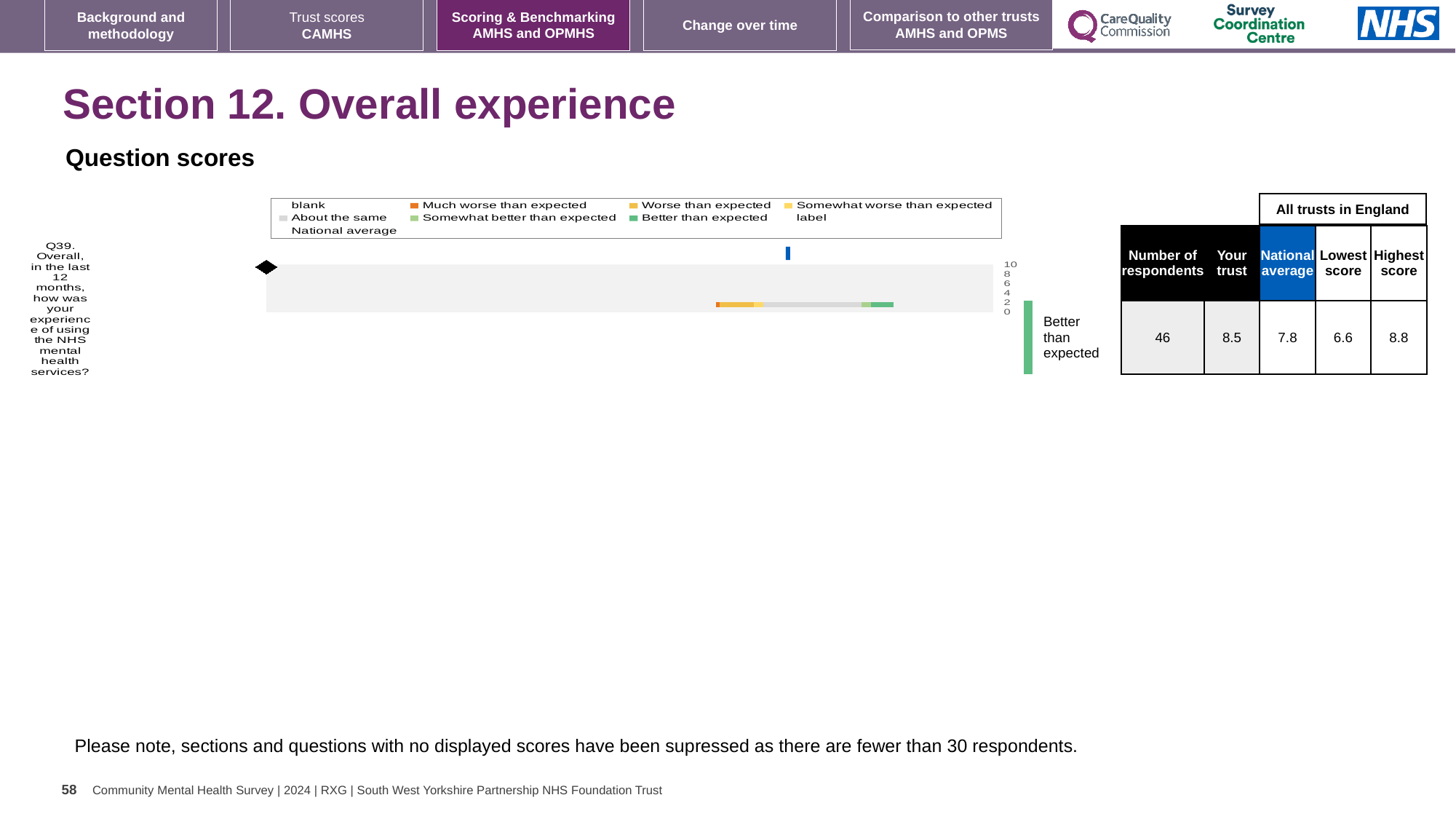
Is the trust's score for Q39 higher or lower than the national average? higher What is the difference between the trust's score and the national average for Q39? 0.7 What is the national average score for Q39? 7.8 How many questions are plotted in the question scores chart? 1 How many respondents answered Q39? 46 Which legend entry is shown in dark green in the question scores chart? Better than expected What is the lowest score among all trusts in England for Q39? 6.6 What kind of chart is used to show the Q39 question score? bar chart What is the trust's score for Q39 (Overall, in the last 12 months, how was your experience of using the NHS mental health services?)? 8.5 What is the highest score among all trusts in England for Q39? 8.8 How is the trust's result for Q39 categorised relative to expectation? Better than expected What is the difference between the highest and lowest scores among all trusts in England for Q39? 2.2